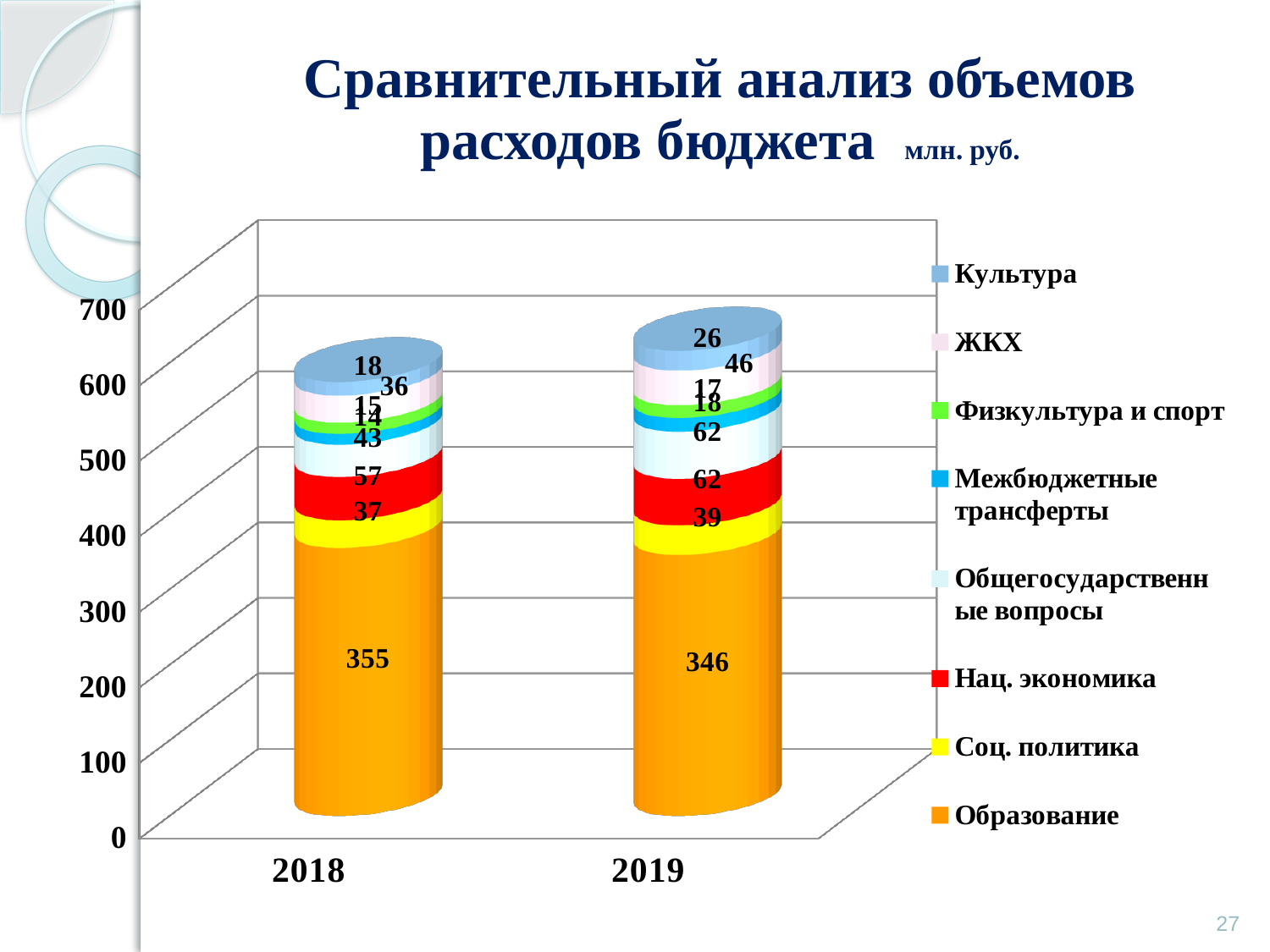
How many years are shown on the x axis? 2 Which year has the larger value for ЖКХ, 2018 or 2019? 2019 What is the difference between the Культура values for 2019 and 2018? 8 How many series does the legend list? 8 What is the value for ЖКХ in 2018? 36 What is the value for Образование in 2018? 355 What is the value for Образование in 2019? 346 What is the value for Соц. политика in 2019? 39 What is the value for Нац. экономика in 2019? 62 Which series has the largest segment in the 2018 bar? Образование By how much did the value for Образование decrease from 2018 to 2019? 9 What is the value for Культура in 2019? 26